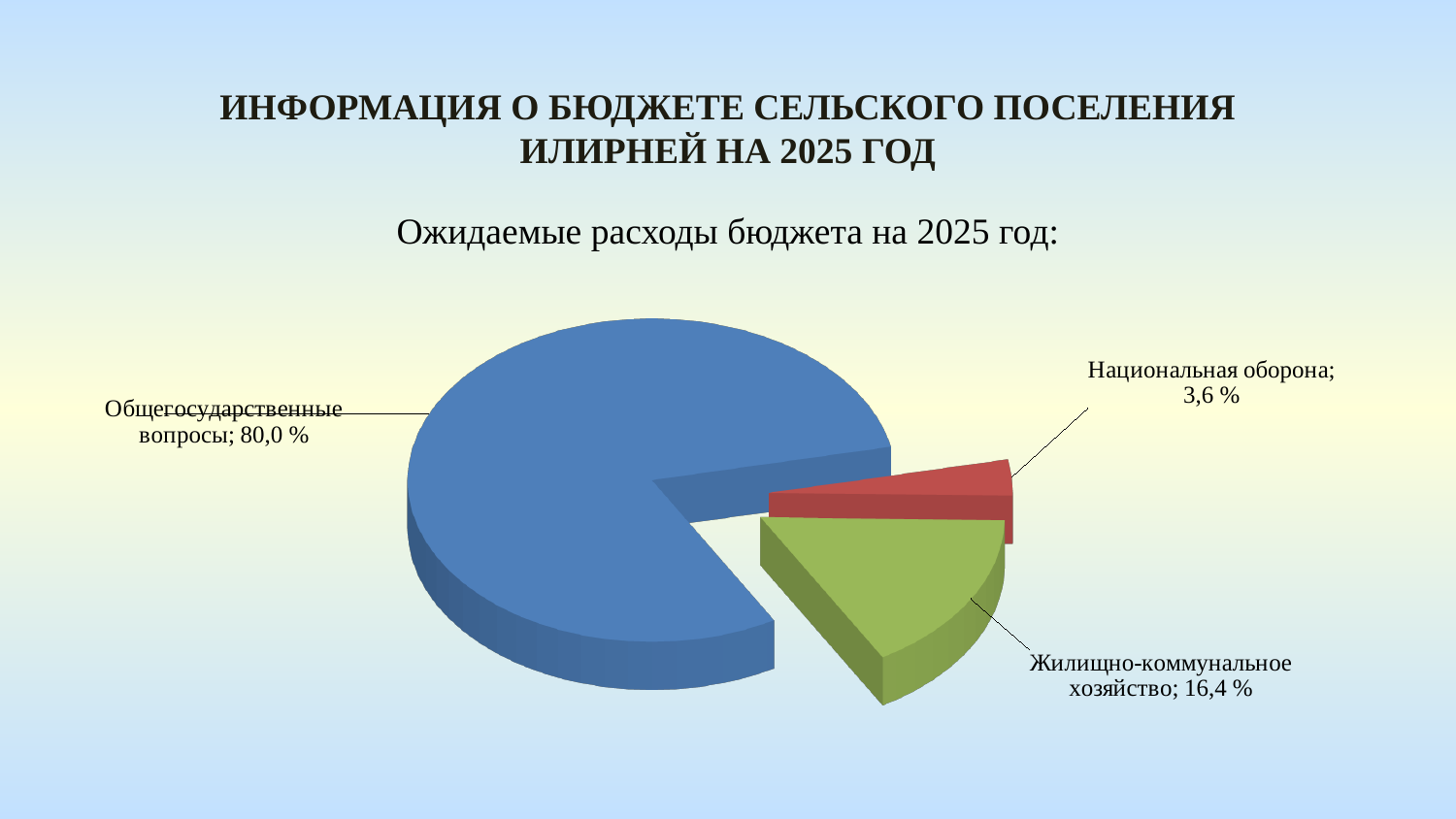
What colour is the slice for Национальная оборона? Red What is the difference between the shares of Жилищно-коммунальное хозяйство and Национальная оборона? 12,8 % What is the subtitle above the chart? Ожидаемые расходы бюджета на 2025 год: What kind of chart is shown on the slide? Pie chart How many categories are shown in the pie chart? 3 What is the difference between the shares of Общегосударственные вопросы and Жилищно-коммунальное хозяйство? 63,6 % What is the value shown for Жилищно-коммунальное хозяйство? 16,4 % Which is larger, the share for Жилищно-коммунальное хозяйство or for Национальная оборона? Жилищно-коммунальное хозяйство Which category has the smallest slice of the pie? Национальная оборона What share of the pie does Общегосударственные вопросы have? 80,0 % What is the value shown for Национальная оборона? 3,6 % Which category has the largest slice of the pie? Общегосударственные вопросы